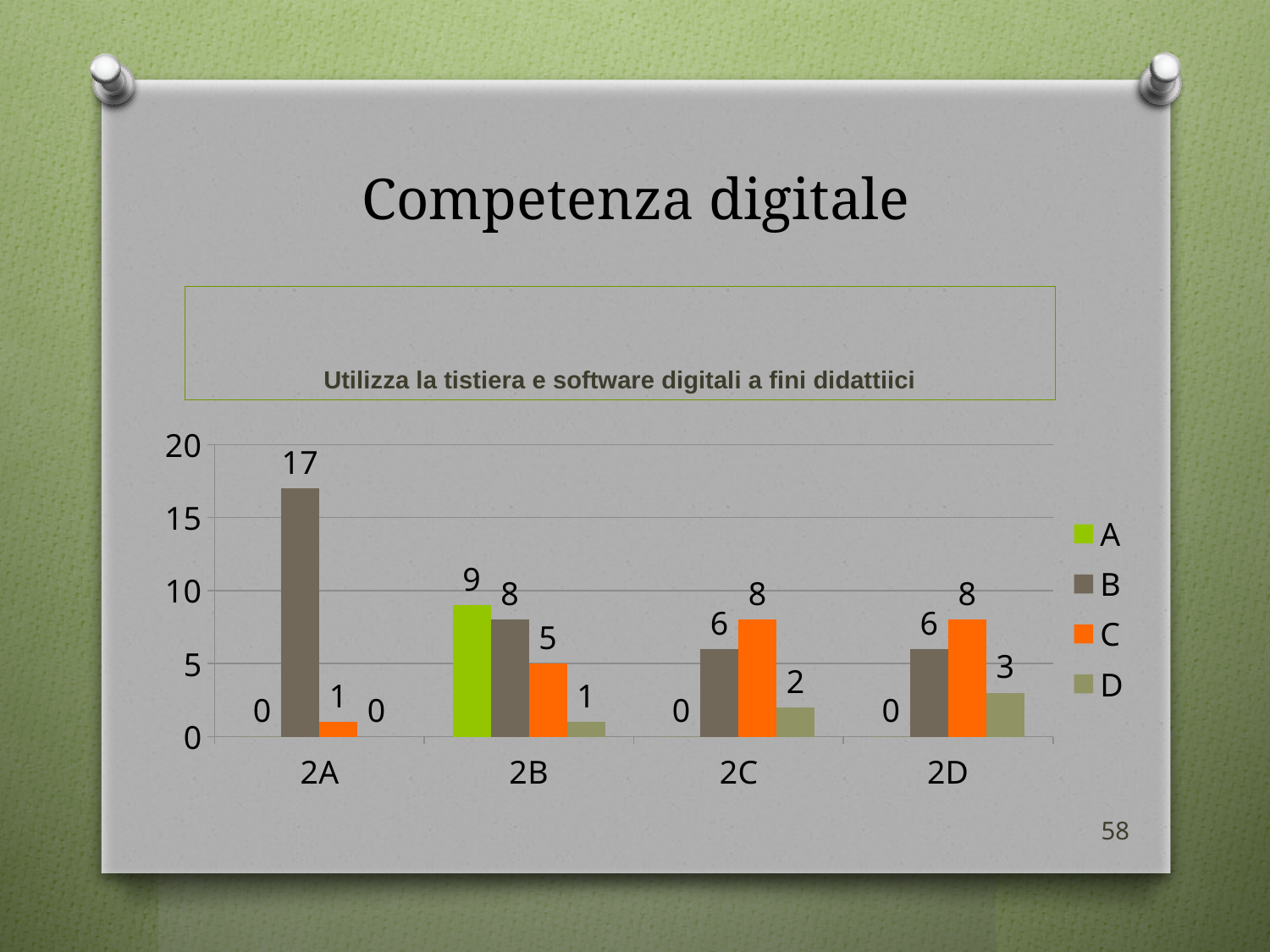
How many classes are shown on the x axis? 4 How many series does the legend list? 4 What kind of chart is shown on the slide? Bar chart What is the difference between series B and series C for class 2B? 3 What is the value of series A for class 2B? 9 Which class has the lowest value for series C? 2A What is the title of the chart? Utilizza la tistiera e software digitali a fini didattiici What is the value of series B for class 2A? 17 What is the value of series C for class 2C? 8 Which class has the highest value for series B? 2A Which is larger for class 2D: series B or series C? C What is the value of series D for class 2D? 3